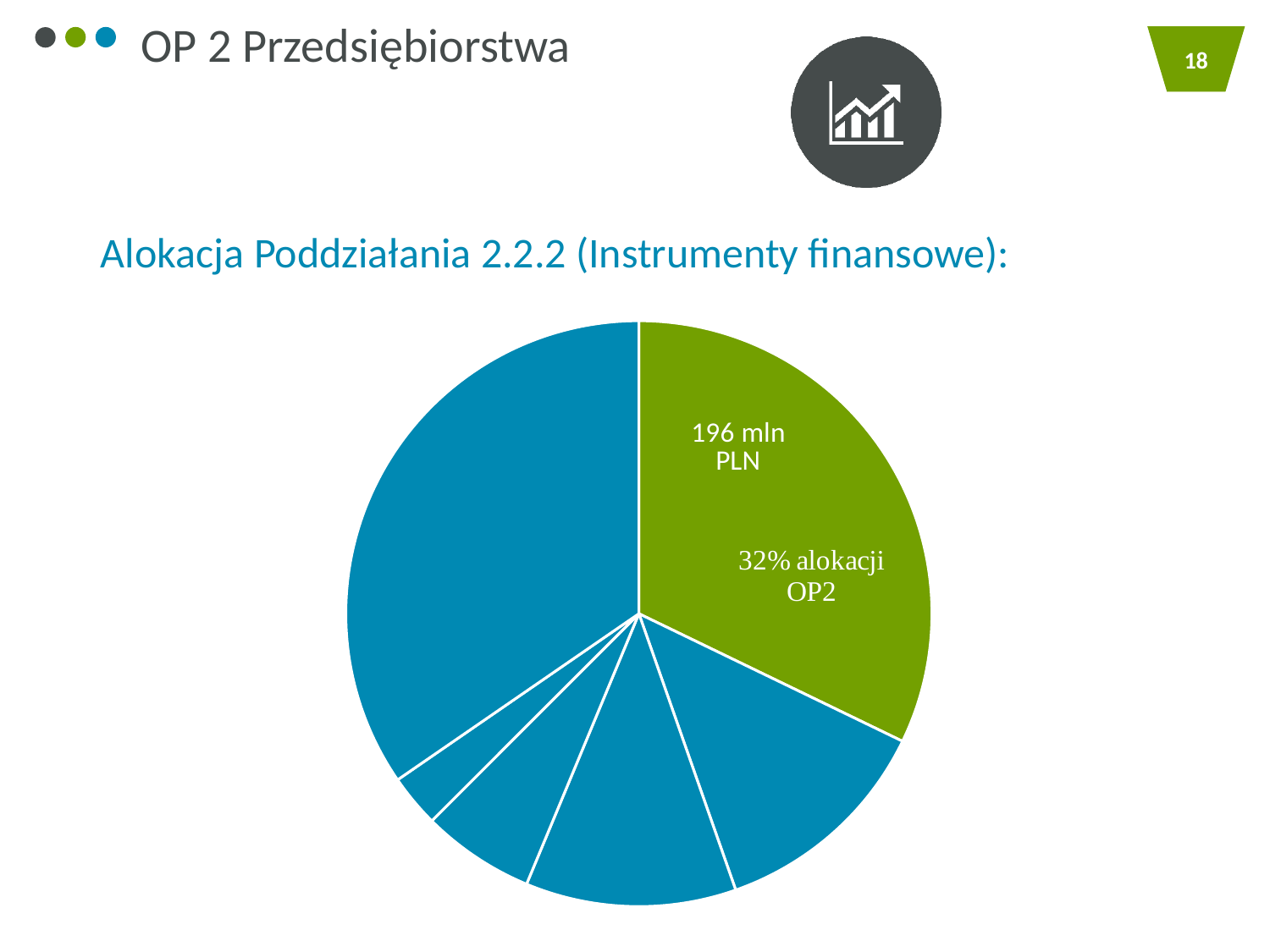
What value is printed on the green slice of the pie chart? 196 mln PLN What share of the OP2 allocation does the green slice (Poddziałanie 2.2.2) represent? 32% alokacji OP2 What colour is the slice representing Poddziałanie 2.2.2 (Instrumenty finansowe)? green Is the share of the green slice greater or less than 25% of the pie? greater Is the share of the green slice greater or less than 50% of the pie? less What kind of chart is shown on the slide? pie chart How many slices does the pie chart have? 6 Does the pie chart have a legend? No Which is larger: the green slice or the small blue slice immediately clockwise from it (at the lower right)? the green slice What is the title printed above the pie chart? Alokacja Poddziałania 2.2.2 (Instrumenty finansowe):